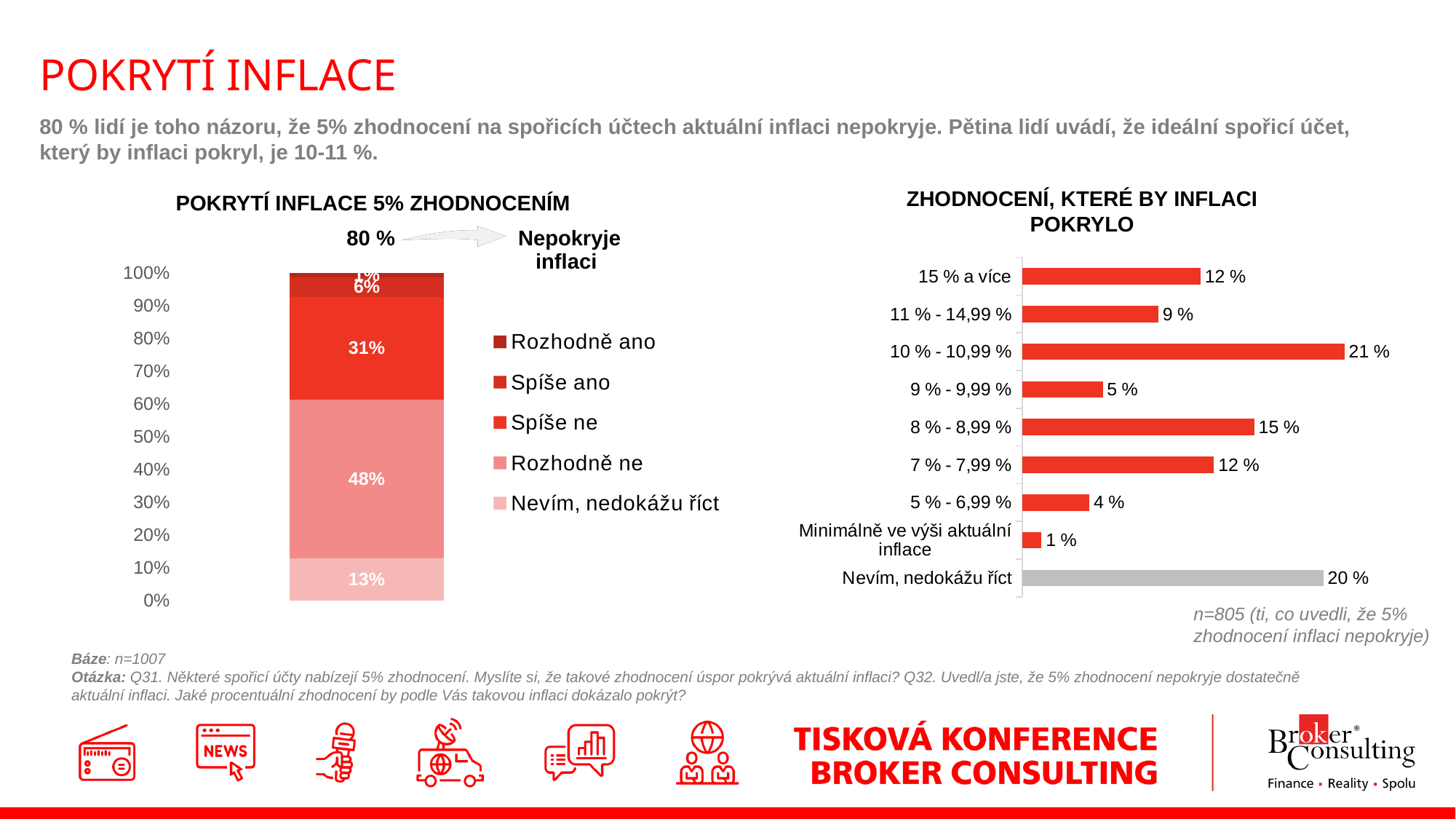
In the chart 'POKRYTÍ INFLACE 5% ZHODNOCENÍM', what is the value for 'Spíše ano'? 6% In the chart 'ZHODNOCENÍ, KTERÉ BY INFLACI POKRYLO', which is larger: '9 % - 9,99 %' or '5 % - 6,99 %'? 9 % - 9,99 % In the chart 'ZHODNOCENÍ, KTERÉ BY INFLACI POKRYLO', what is the value for '8 % - 8,99 %'? 15 % In the chart 'POKRYTÍ INFLACE 5% ZHODNOCENÍM', what is the combined value of 'Spíše ne' and 'Rozhodně ne'? 79% What type of chart is 'ZHODNOCENÍ, KTERÉ BY INFLACI POKRYLO'? Bar chart In the chart 'ZHODNOCENÍ, KTERÉ BY INFLACI POKRYLO', what is the value for '10 % - 10,99 %'? 21 % How many categories are shown in the chart 'ZHODNOCENÍ, KTERÉ BY INFLACI POKRYLO'? 9 In the chart 'ZHODNOCENÍ, KTERÉ BY INFLACI POKRYLO', which category has the highest value? 10 % - 10,99 % In the chart 'ZHODNOCENÍ, KTERÉ BY INFLACI POKRYLO', which category has the lowest value? Minimálně ve výši aktuální inflace In the chart 'POKRYTÍ INFLACE 5% ZHODNOCENÍM', what is the value for 'Rozhodně ne'? 48% In the chart 'ZHODNOCENÍ, KTERÉ BY INFLACI POKRYLO', what is the difference between '10 % - 10,99 %' and '11 % - 14,99 %'? 12 % How many series does the legend of the chart 'POKRYTÍ INFLACE 5% ZHODNOCENÍM' list? 5